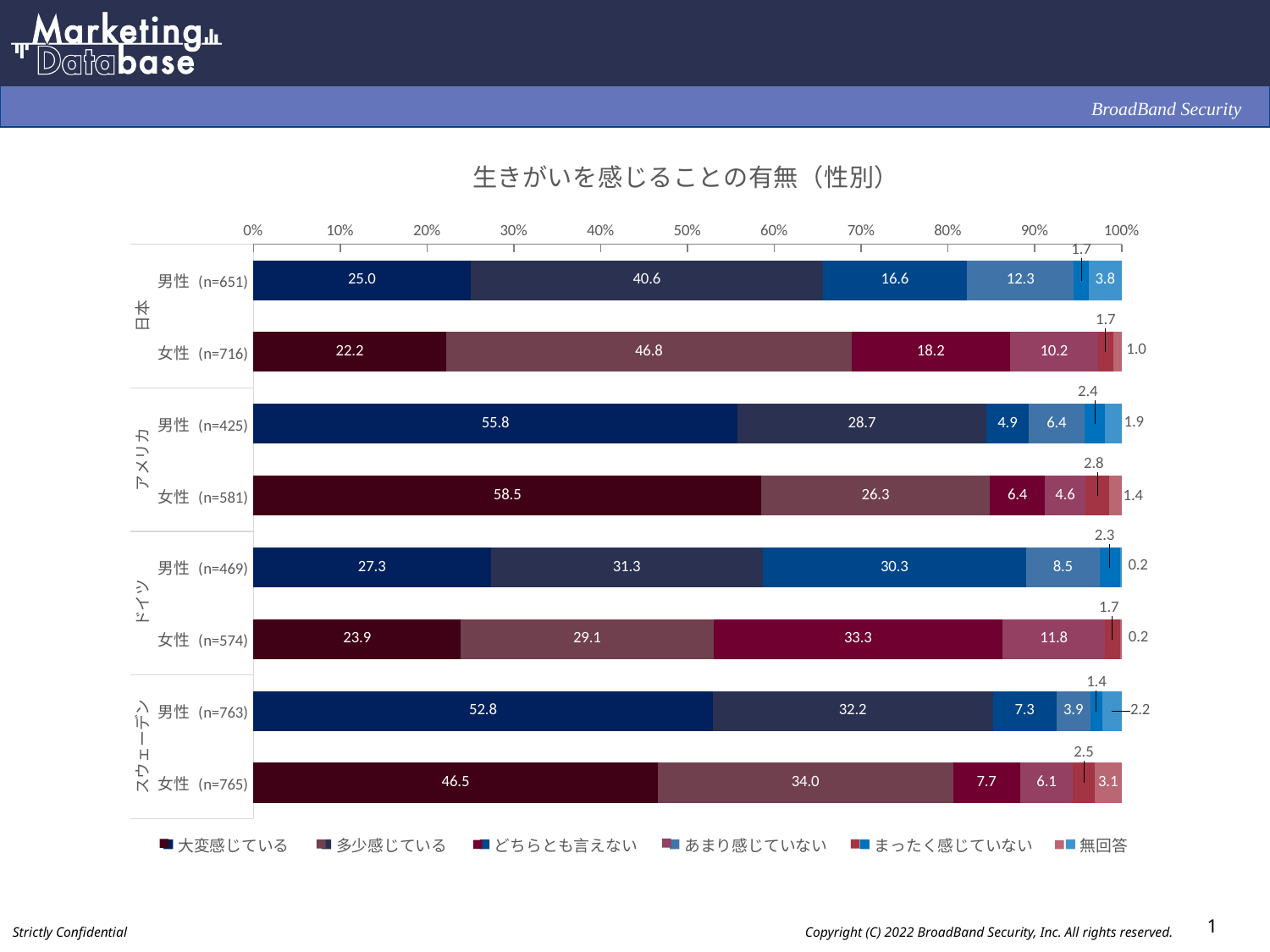
Which group has the highest value for 大変感じている? アメリカ 女性 (n=581) What is the value of 大変感じている for 日本 男性 (n=651)? 25.0 How many series does the legend list? 6 What is the value of 多少感じている for 日本 女性 (n=716)? 46.8 How many bars (groups) are plotted in the chart? 8 What is the value of 無回答 for スウェーデン 女性 (n=765)? 3.1 What is the value of どちらとも言えない for ドイツ 女性 (n=574)? 33.3 Which group has the lowest value for 大変感じている? 日本 女性 (n=716) What is the title of the chart? 生きがいを感じることの有無（性別） Which is larger: the 多少感じている value for スウェーデン 男性 (n=763) or for アメリカ 男性 (n=425)? スウェーデン 男性 (n=763) What type of chart is shown on the slide? Stacked bar chart What is the difference between the 大変感じている values for アメリカ 女性 (n=581) and 日本 女性 (n=716)? 36.3